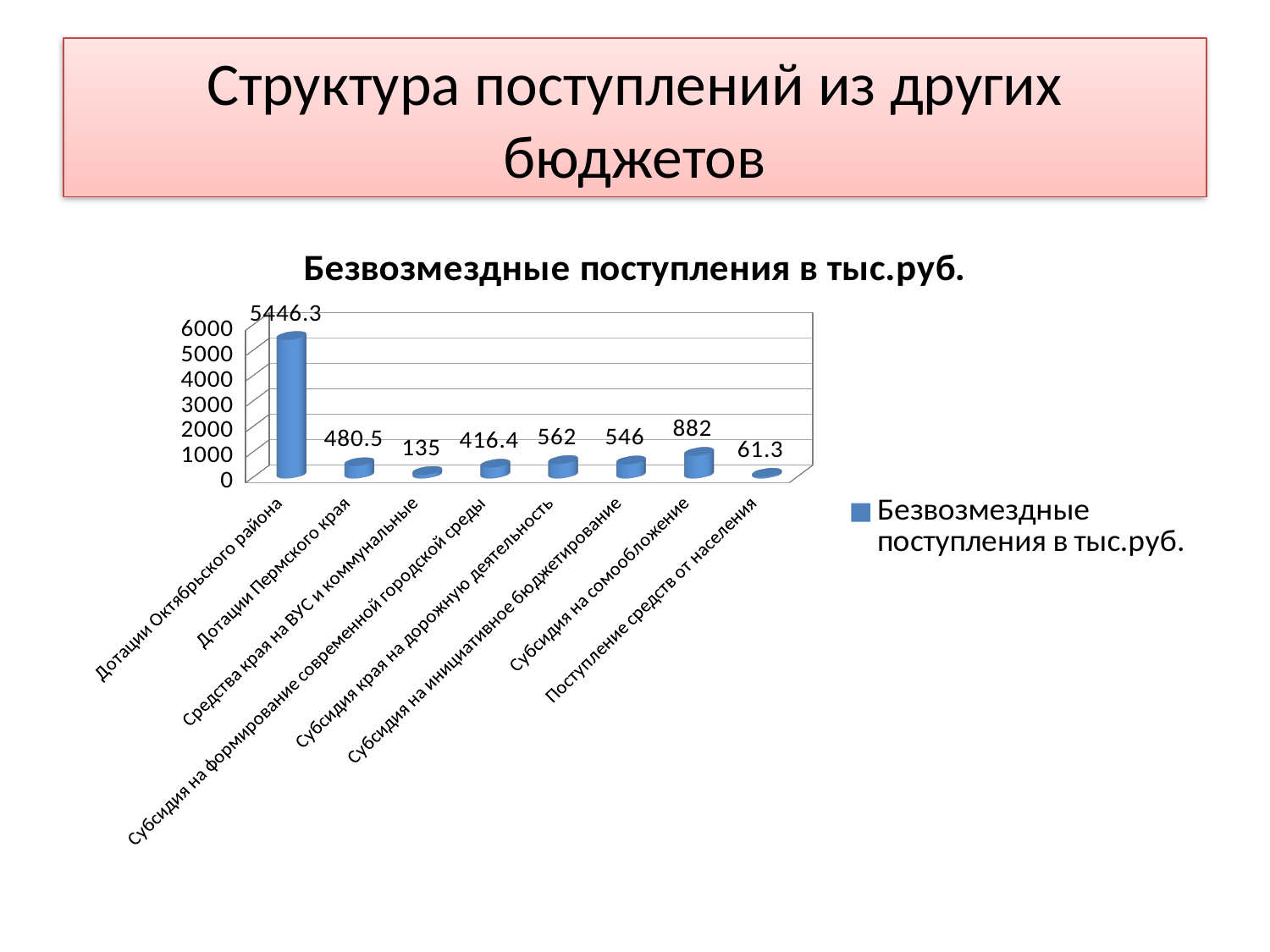
What is the value for Дотации Октябрьского района? 5446.3 What is the value for Средства края на ВУС и коммунальные? 135 What is the title of the chart? Безвозмездные поступления в тыс.руб. What kind of chart is shown on the slide? bar chart How many series does the legend list? 1 Is the value for Субсидия на самообложение greater or less than 1000? less What is the value for Субсидия на самообложение? 882 How many categories are shown on the chart? 8 What is the difference between the values for Субсидия края на дорожную деятельность and Субсидия на инициативное бюджетирование? 16 Which category has the lowest value? Поступление средств от населения Which category has the highest value? Дотации Октябрьского района Which is larger: the value for Дотации Пермского края or the value for Субсидия на формирование современной городской среды? Дотации Пермского края